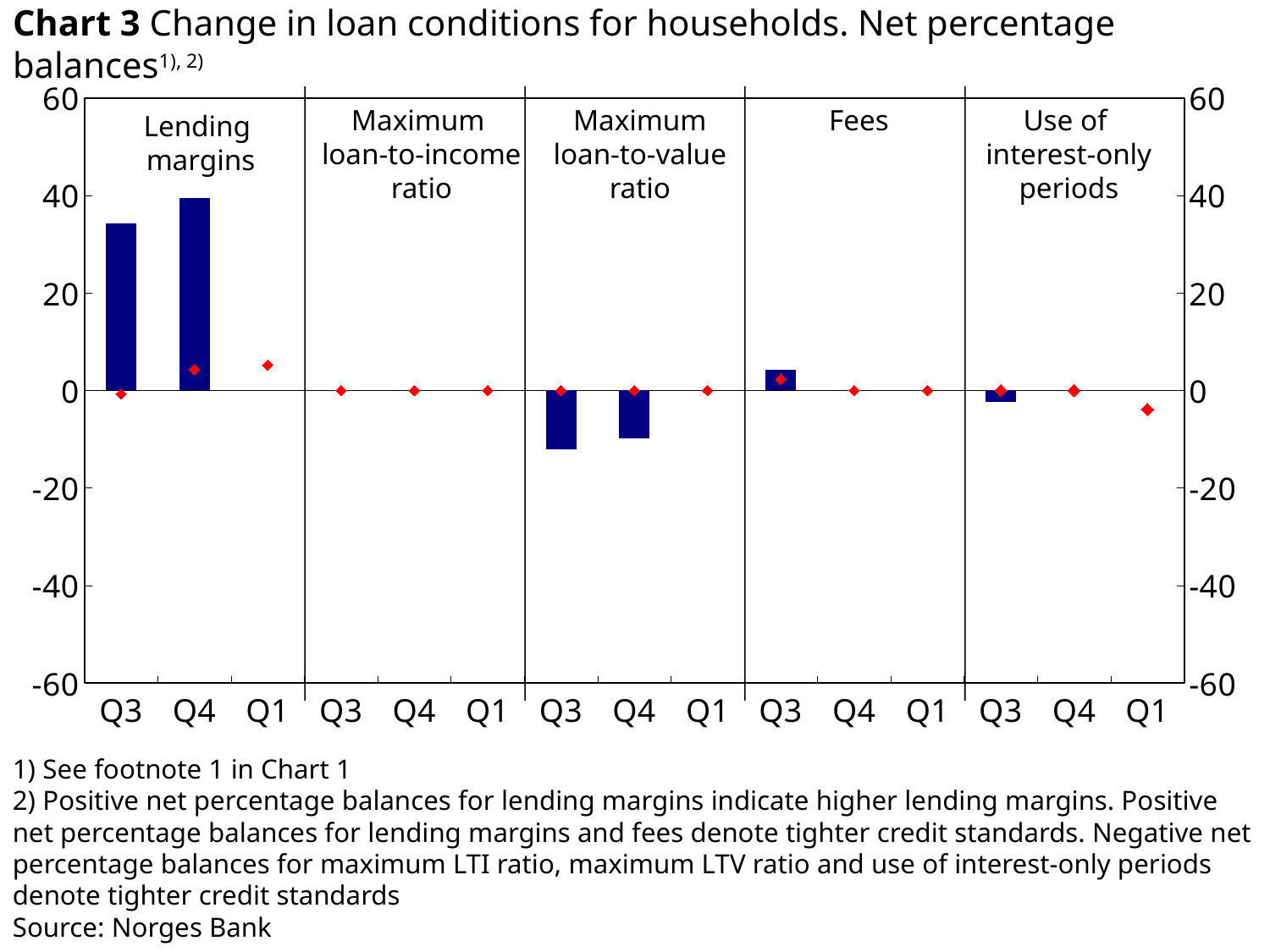
How many loan-condition panels are shown in Chart 3? 5 Do the Lending margins bars rise or fall from Q3 to Q4? rise Which panel contains the tallest bar in Chart 3? Lending margins How many quarters are shown in each panel of Chart 3? 3 Is the Q3 bar for Maximum loan-to-value ratio greater or less than -20? greater Is the Q4 bar for Lending margins greater or less than 20? greater Is the Q3 bar for Fees greater or less than 20? less Which bar is the lowest (most negative) in Chart 3? Q3 for Maximum loan-to-value ratio What kind of chart is Chart 3? bar chart with red diamond markers (combination bar and marker chart) What colour are the bars in Chart 3? dark blue In the Lending margins panel, which bar is taller, Q3 or Q4? Q4